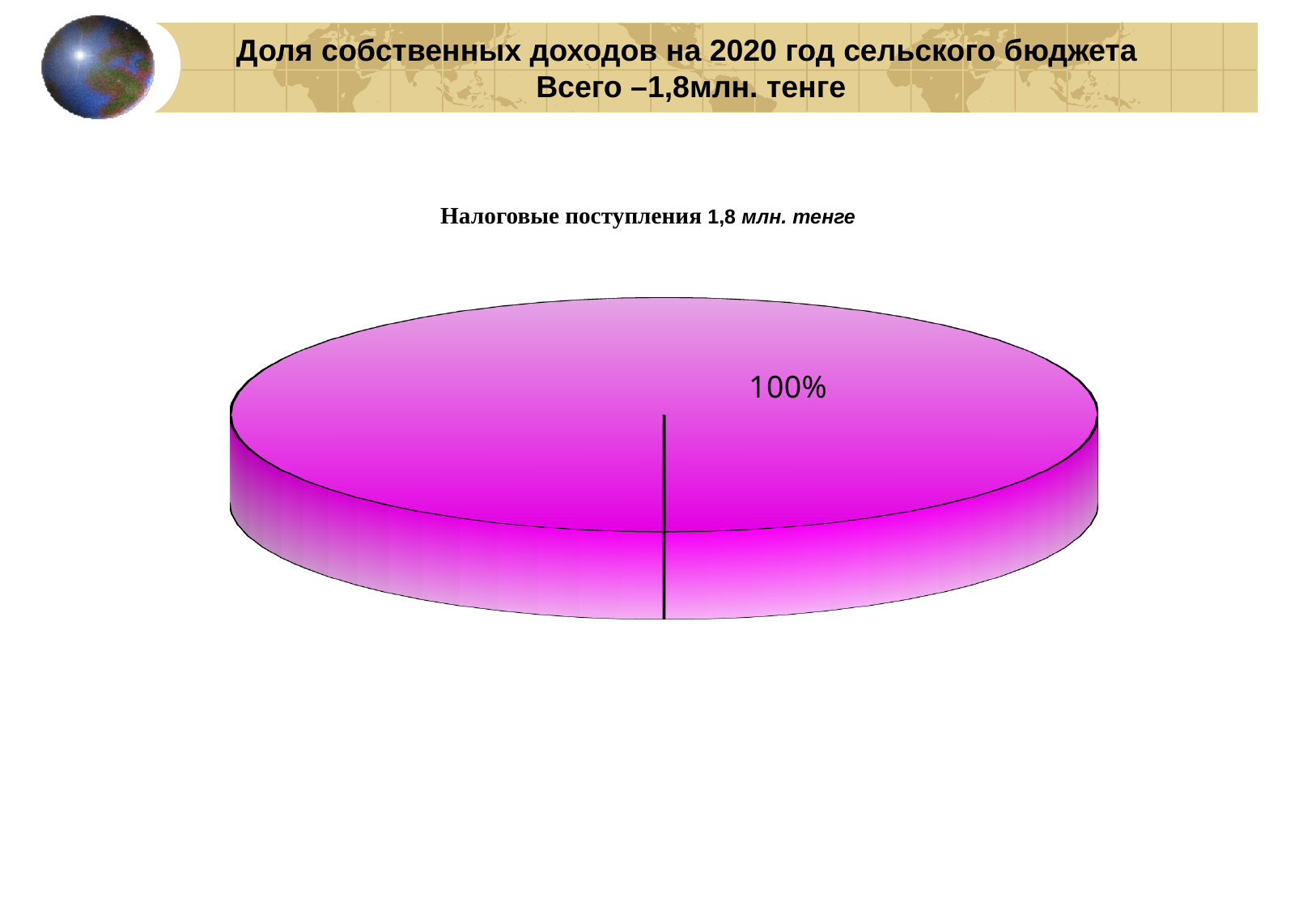
According to the chart title, what is the amount of tax revenue (Налоговые поступления)? 1,8 млн. тенге What kind of chart is shown on the slide? pie chart What colour is the pie chart slice? magenta (pink-purple) What is the title of the pie chart? Налоговые поступления 1,8 млн. тенге How many slices does the pie chart have? 1 What share of the pie does the single slice represent? 100% What percentage label is printed on the pie chart? 100%